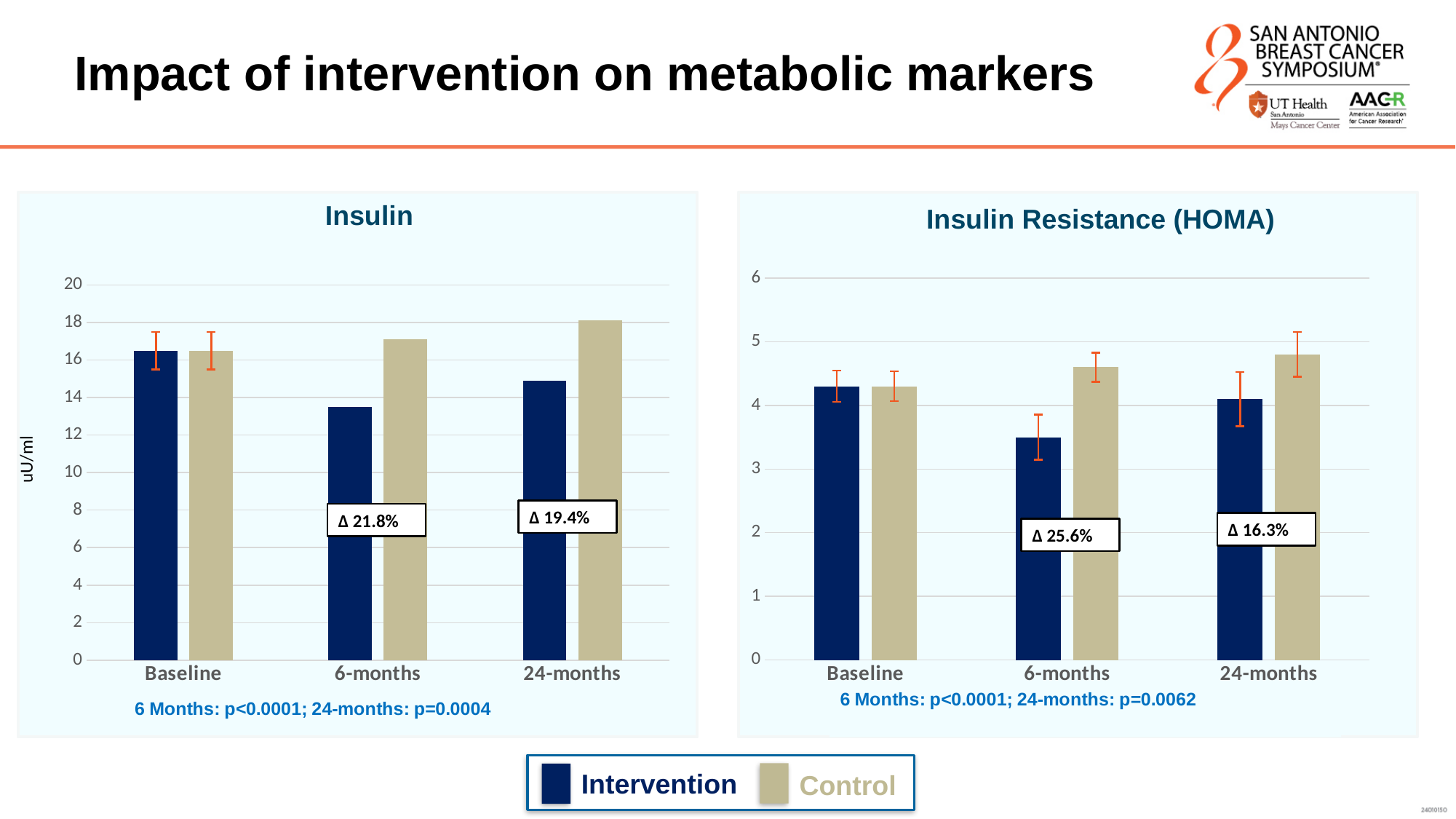
In the Insulin chart, what percentage change (Δ) is labelled at 6-months? Δ 21.8% In the Insulin chart, at 24-months, which is larger: Intervention or Control? Control In the Insulin chart, is the Control value at 6-months greater or less than 16? greater What kind of chart is the Insulin chart? bar chart In the Insulin chart, at which time point is the Intervention bar lowest? 6-months In the Insulin chart, is the Intervention value at 6-months greater or less than 14? less In the Insulin Resistance (HOMA) chart, what percentage change (Δ) is labelled at 24-months? Δ 16.3% How many series does the legend list? 2 What is the y-axis label of the Insulin chart? uU/ml In the Insulin chart, how many time-point categories are shown on the x axis? 3 In the Insulin Resistance (HOMA) chart, is the Intervention value at 6-months greater or less than 4? less In the Insulin chart, do the Control values rise or fall from Baseline to 24-months? rise